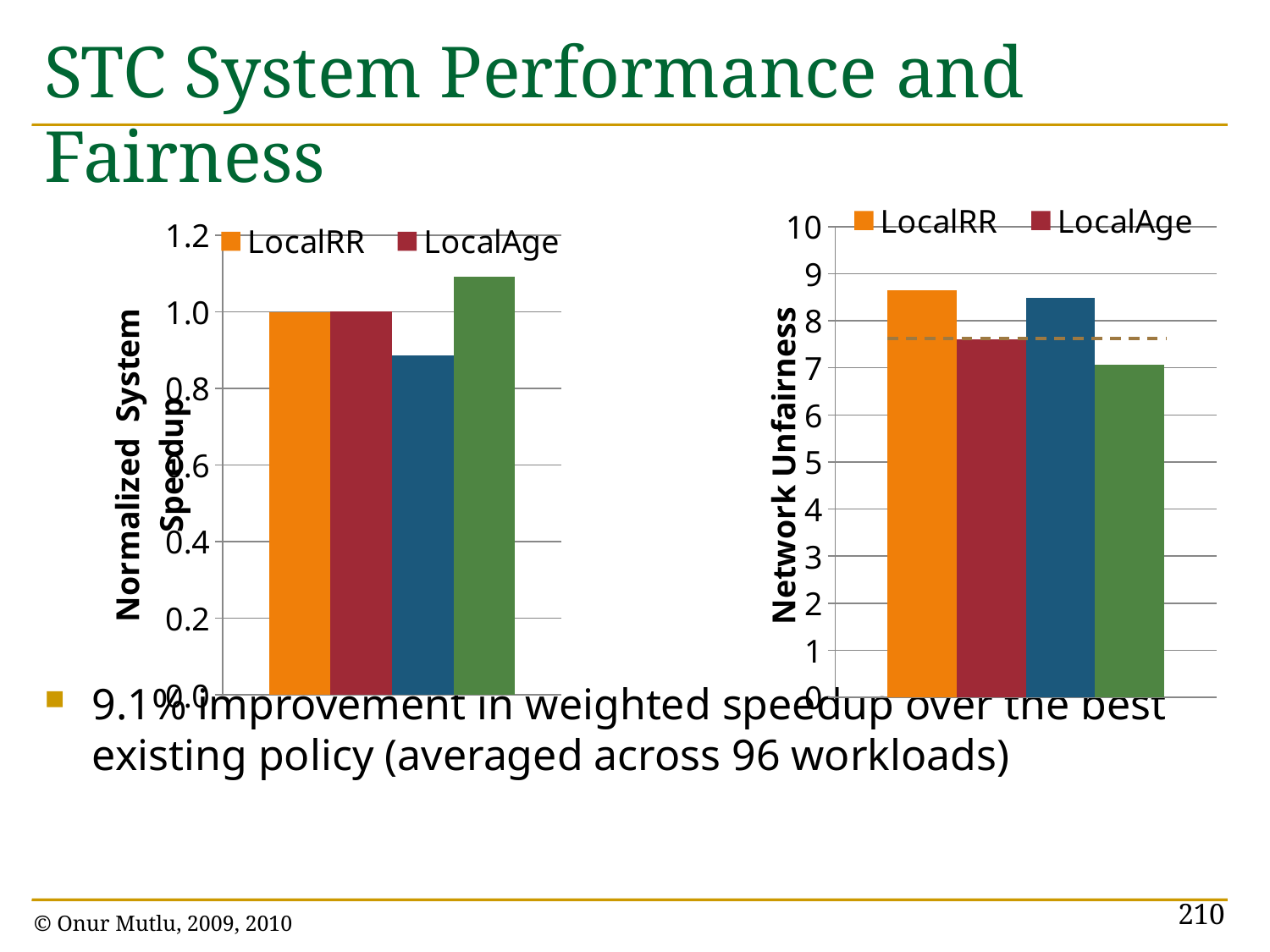
What kind of chart is the left chart (Normalized System Speedup)? bar chart In the left chart (Normalized System Speedup), how many bars are plotted? 4 What colour is the LocalRR series in the legends? orange In the right chart, is the Network Unfairness for LocalRR greater or less than 8? greater In the right chart (Network Unfairness), how many bars are plotted? 4 How many series does the legend of the right chart (Network Unfairness) list? 2 In the right chart, is the Network Unfairness for LocalAge greater or less than 8? less In the right chart, which has higher Network Unfairness, LocalRR or LocalAge? LocalRR In the right chart, which of the two legend series, LocalRR or LocalAge, has the lower Network Unfairness? LocalAge In the left chart, what is the Normalized System Speedup for LocalRR? 1.0 What is the y-axis title of the right chart? Network Unfairness